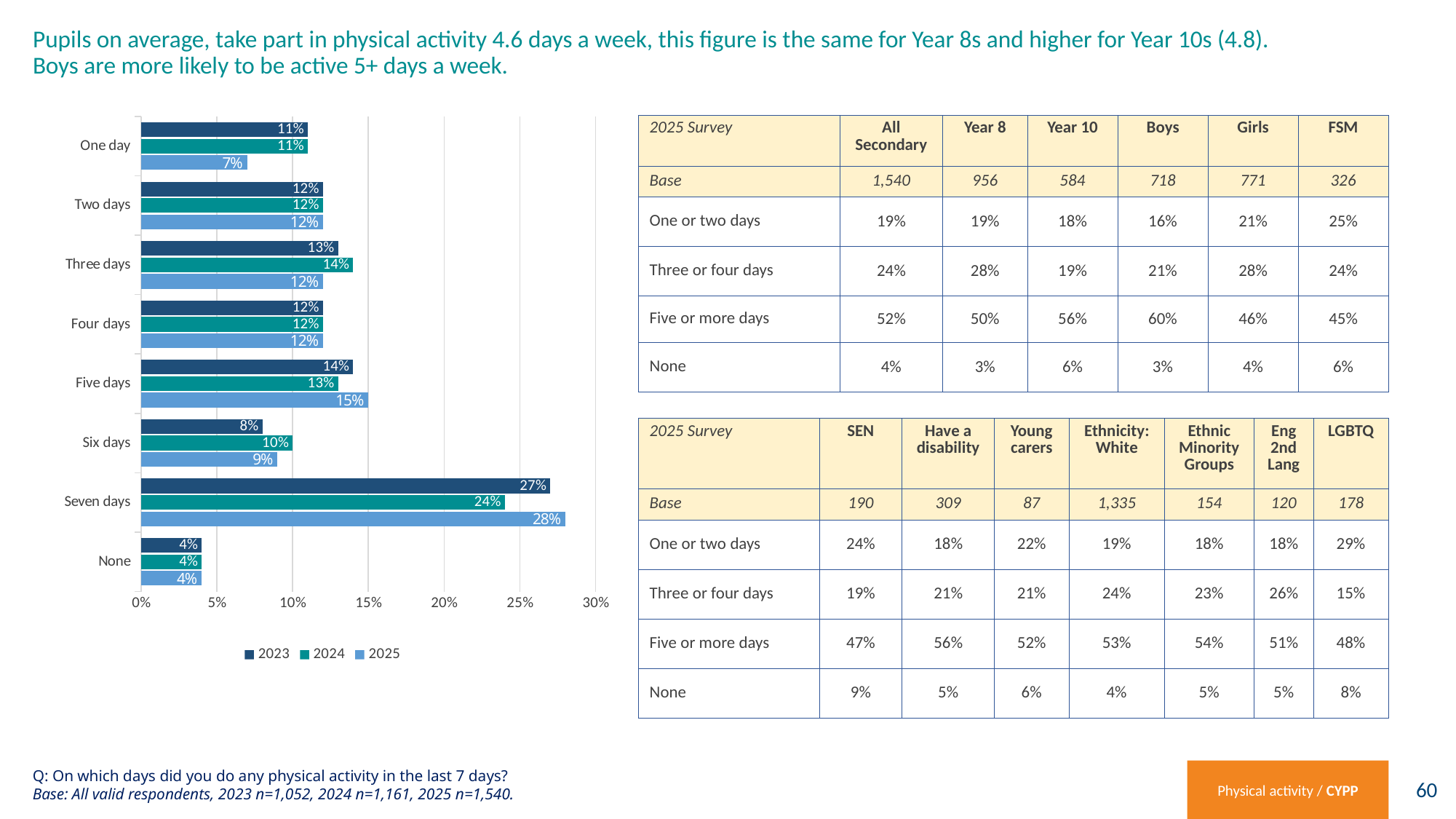
What is the 2023 value for One day? 11% Which years are listed in the chart legend? 2023, 2024, 2025 What is the 2025 value for Seven days? 28% What kind of chart is shown on the slide? Bar chart Which category has the lowest 2023 value? None What is the 2024 value for Six days? 10% How many categories are shown on the chart? 8 Which is larger for Five days: the 2023 value or the 2025 value? 2025 Is the 2023 value for Seven days greater or less than 25%? greater What is the difference between the 2025 and 2024 values for Seven days? 4 percentage points How many series does the legend list? 3 Which category has the highest 2025 value? Seven days